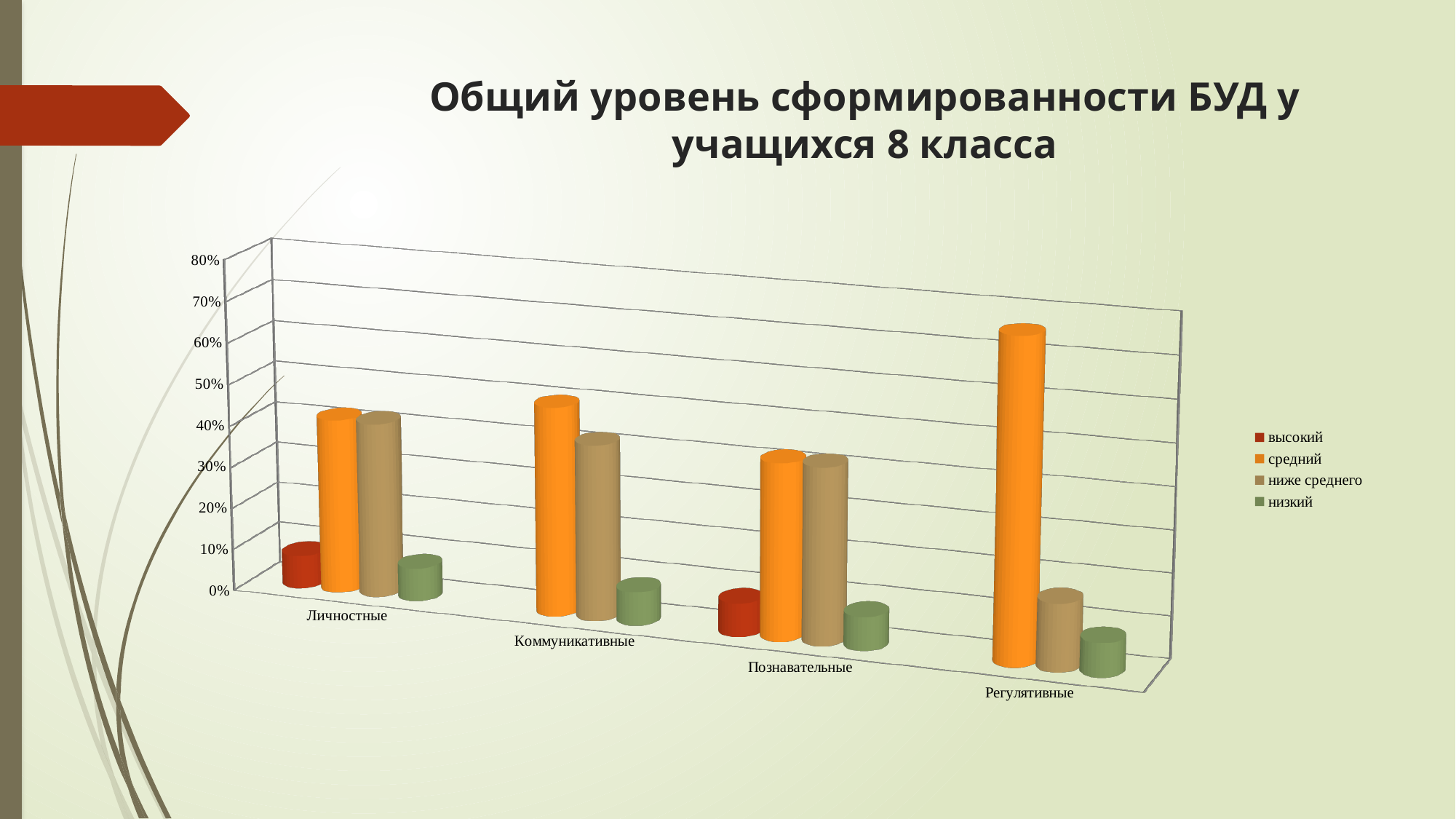
How many series does the chart legend list? 4 Which category has the highest value for the series 'средний'? Регулятивные In the category 'Коммуникативные', which is larger: 'средний' or 'ниже среднего'? средний What colour represents the series 'средний' in the chart legend? orange Is the value for 'высокий' in the category 'Личностные' greater or less than 20%? less How many categories are shown along the x axis of the chart? 4 Which series has the highest value in the category 'Регулятивные'? средний Is the value for 'средний' in the category 'Коммуникативные' greater or less than 30%? greater Which series has the lowest value in the category 'Регулятивные'? низкий What is the title of the chart on the slide? Общий уровень сформированности БУД у учащихся 8 класса What kind of chart is shown on the slide? bar chart Is the value for 'средний' in the category 'Регулятивные' greater or less than 50%? greater